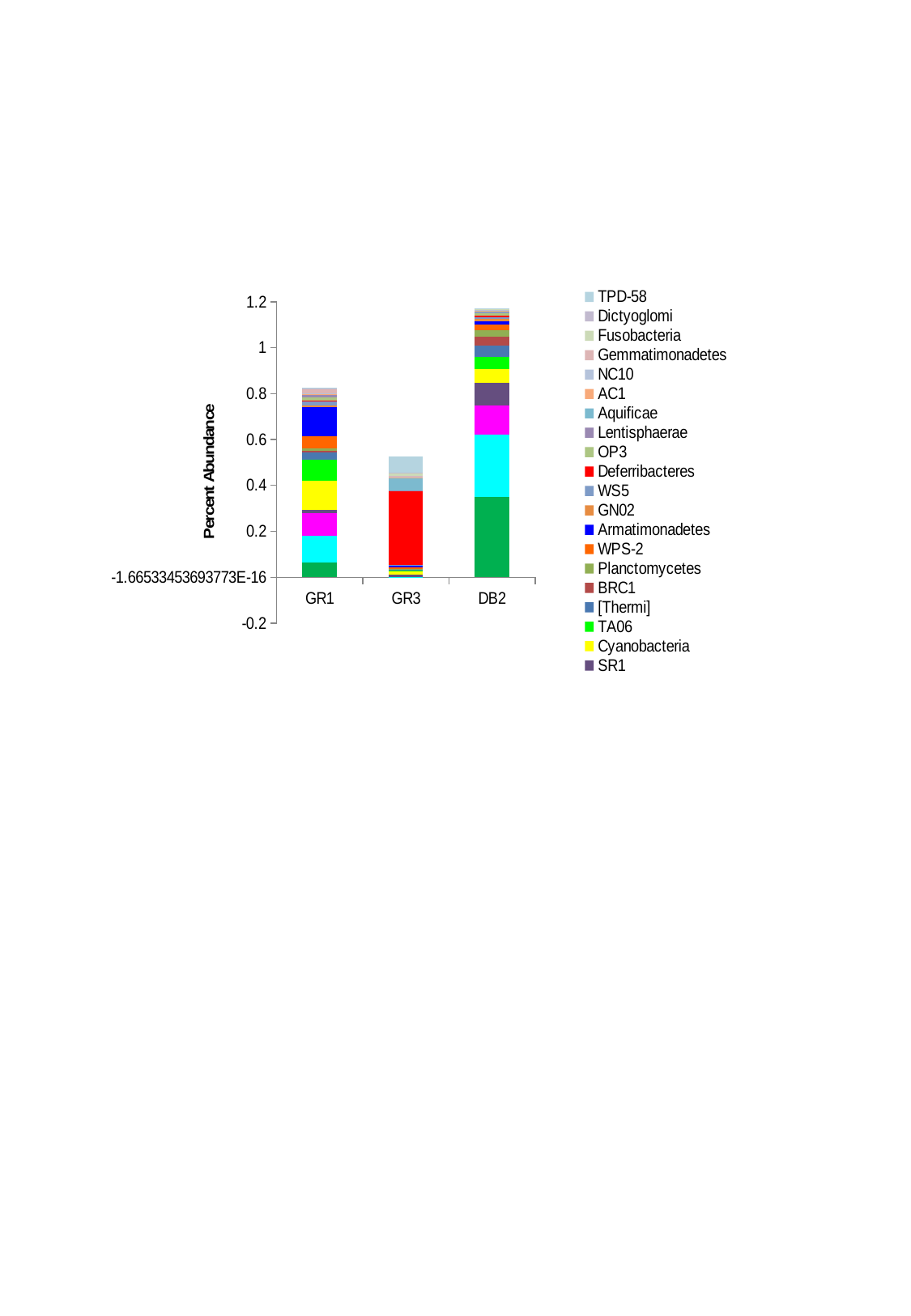
Which category has the tallest stacked bar? DB2 Is the total stacked value for DB2 greater or less than 1? greater How many series does the legend list? 20 What type of chart is shown on the slide? stacked bar chart Is the total stacked value for GR3 greater or less than 0.6? less Which series is shown in red in the legend? Deferribacteres Is the total stacked value for GR1 greater or less than 1? less What is the label of the y axis? Percent Abundance Which category has the shortest stacked bar? GR3 How many categories are shown on the x axis? 3 Which stacked bar is taller, GR1 or DB2? DB2